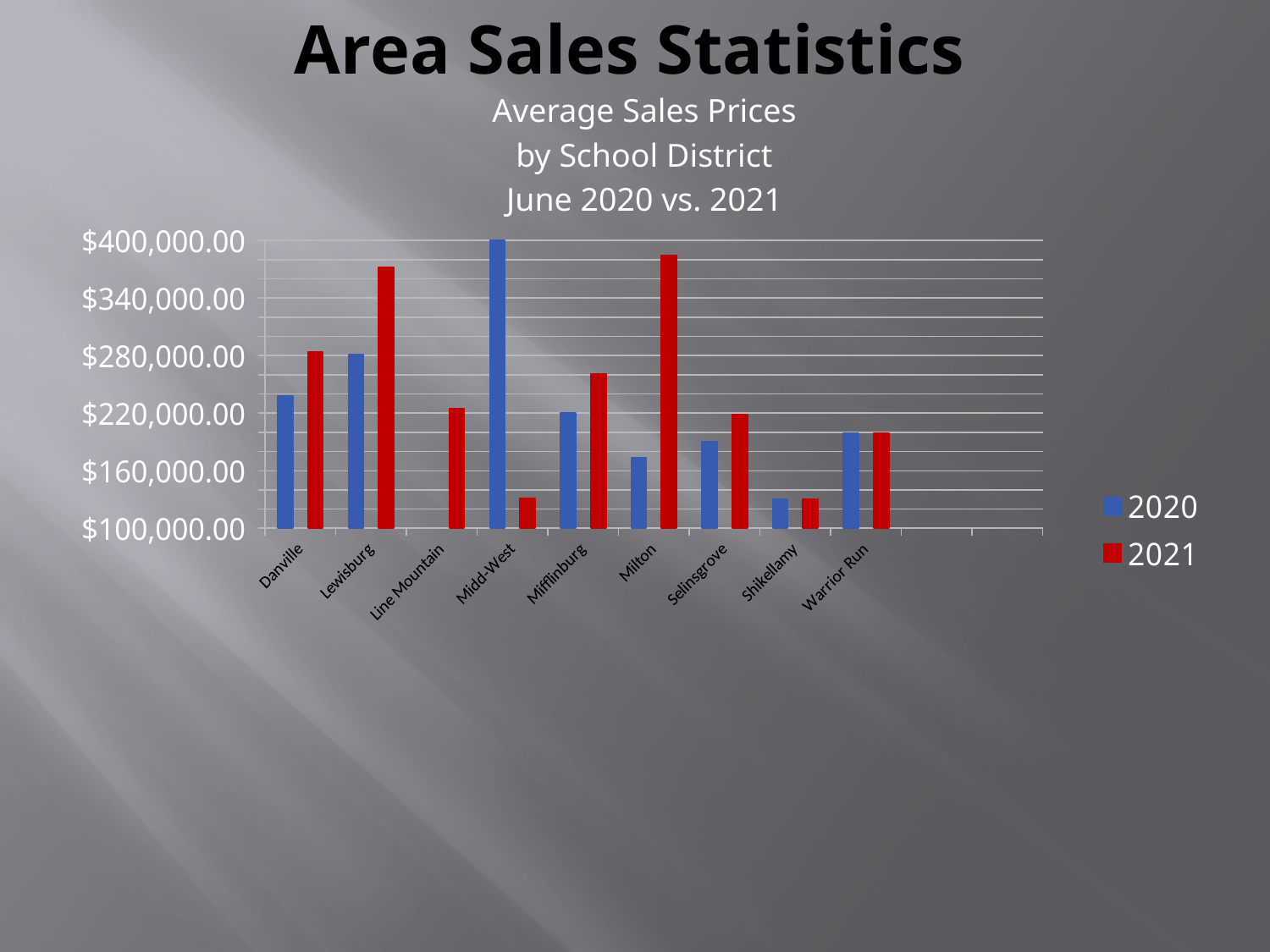
Which colour represents the 2021 series in the legend? Red Which school district has the highest 2021 average sales price? Milton Is the 2020 value for Danville greater or less than $220,000.00? greater Is the 2020 value for Milton greater or less than $220,000.00? less What kind of chart is shown on the slide? Bar chart Is the 2021 value for Lewisburg greater or less than $340,000.00? greater For Milton, which is larger: the 2020 value or the 2021 value? 2021 Which is larger: the 2021 value for Lewisburg or the 2021 value for Danville? Lewisburg Which school district has the highest 2020 average sales price? Midd-West How many series does the legend list? 2 How many school districts are shown on the x axis? 9